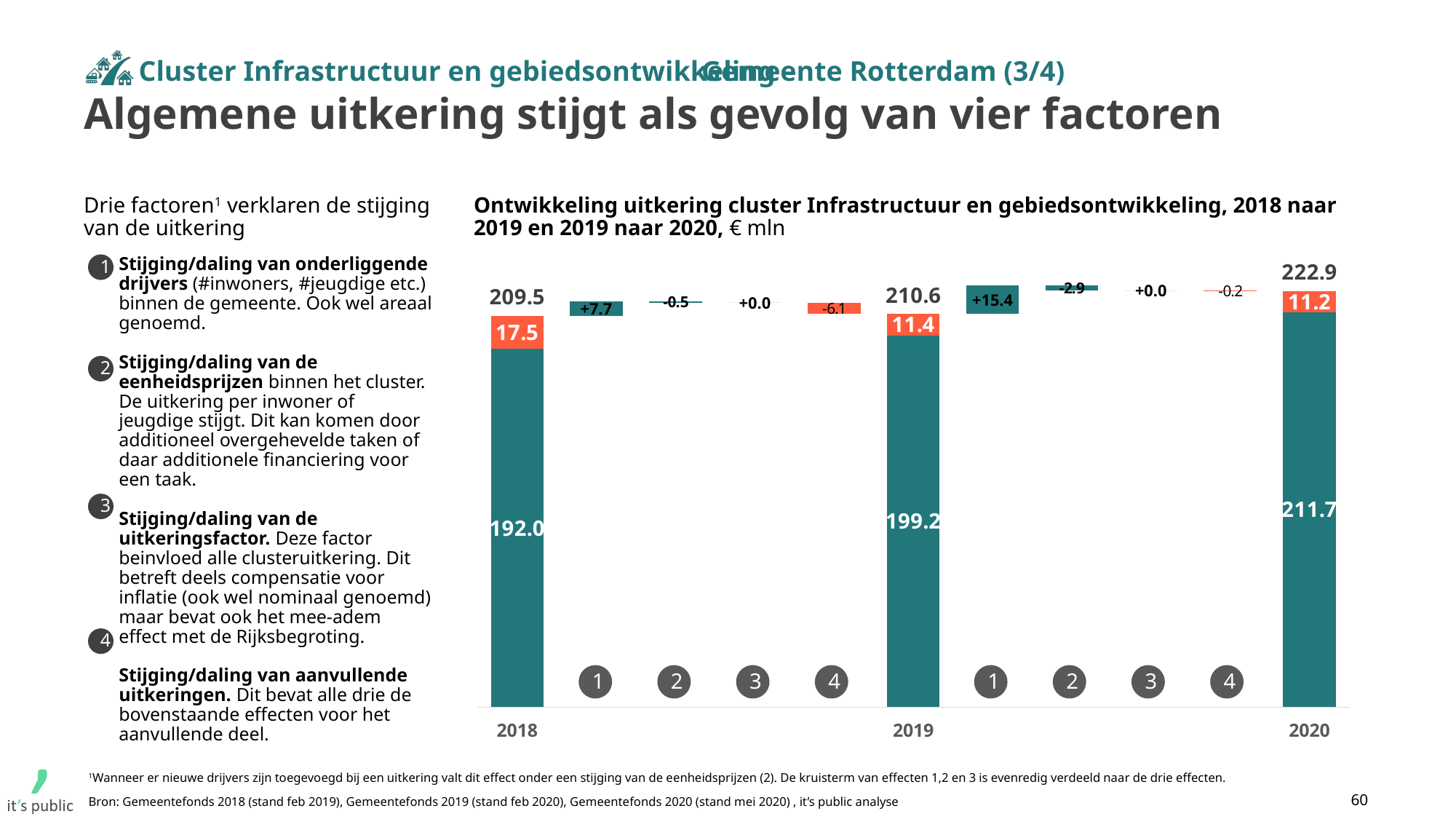
What is the value of step 1 between 2019 and 2020? +15.4 What is the value of the orange (top) segment of the 2019 bar? 11.4 What is the total uitkering shown for 2018? 209.5 Do the year totals rise or fall from 2018 to 2020? rise What is the value of step 4 between 2018 and 2019? -6.1 Which year has the lowest total uitkering? 2018 Which is larger: the orange segment in 2018 or the orange segment in 2020? 2018 What is the difference between the 2020 total (222.9) and the 2019 total (210.6)? 12.3 What is the value of the teal (bottom) segment of the 2020 bar? 211.7 What unit is stated in the chart title? € mln What is the total uitkering shown for 2020? 222.9 Which year has the highest total uitkering? 2020